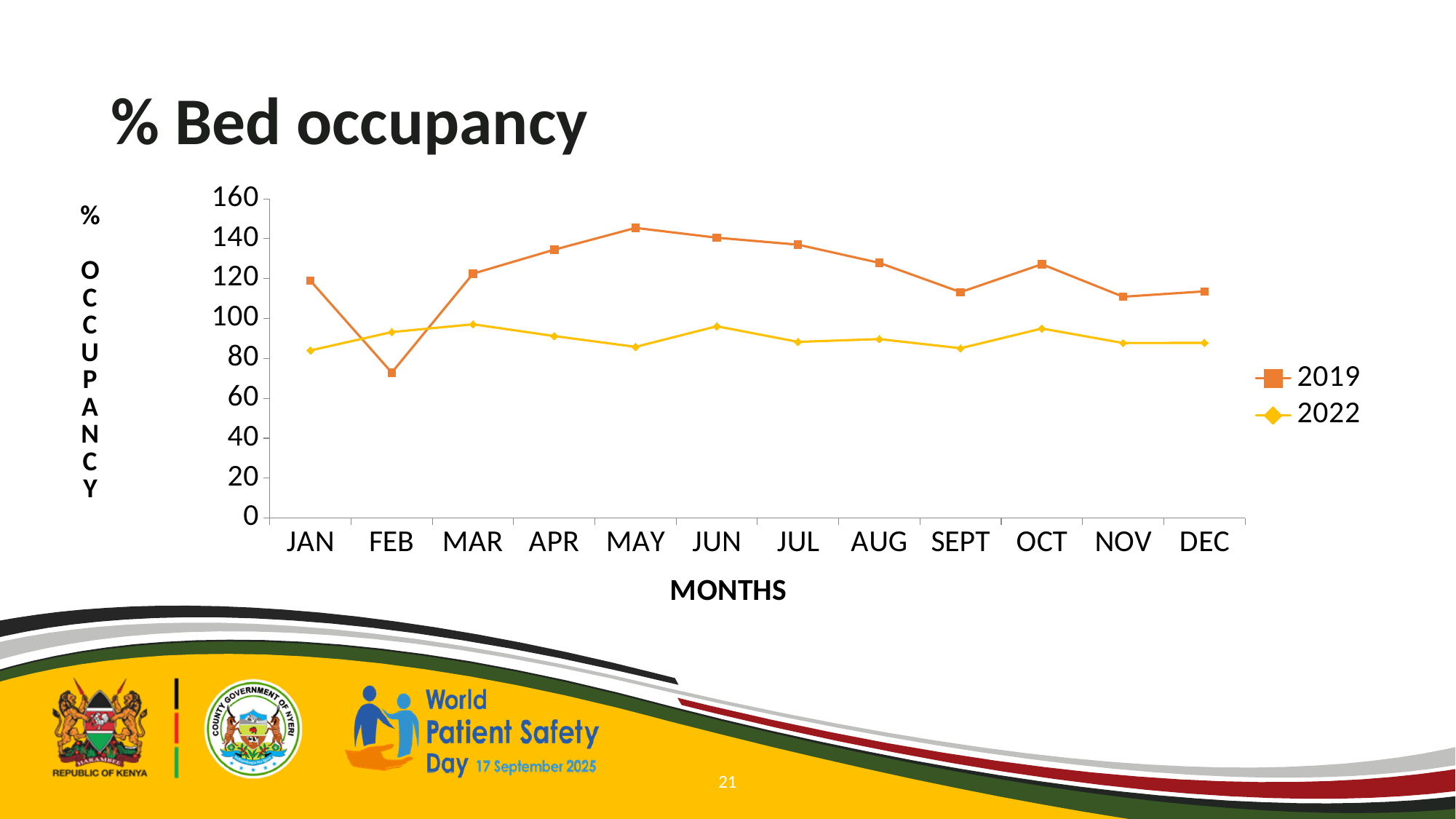
Is the 2019 value for FEB greater or less than 80? less What kind of chart is shown on the slide? line chart How many months are plotted along the x axis? 12 What is the title of the x axis? MONTHS Which series has the higher value in FEB, 2019 or 2022? 2022 Is the 2019 value for MAY greater or less than 140? greater Is the 2022 value for JAN greater or less than 100? less Does the 2019 line rise or fall from MAY to SEPT? fall In which month is the 2019 bed occupancy lowest? FEB Which series has the higher value in JAN, 2019 or 2022? 2019 In which month is the 2019 bed occupancy highest? MAY How many series does the legend list? 2